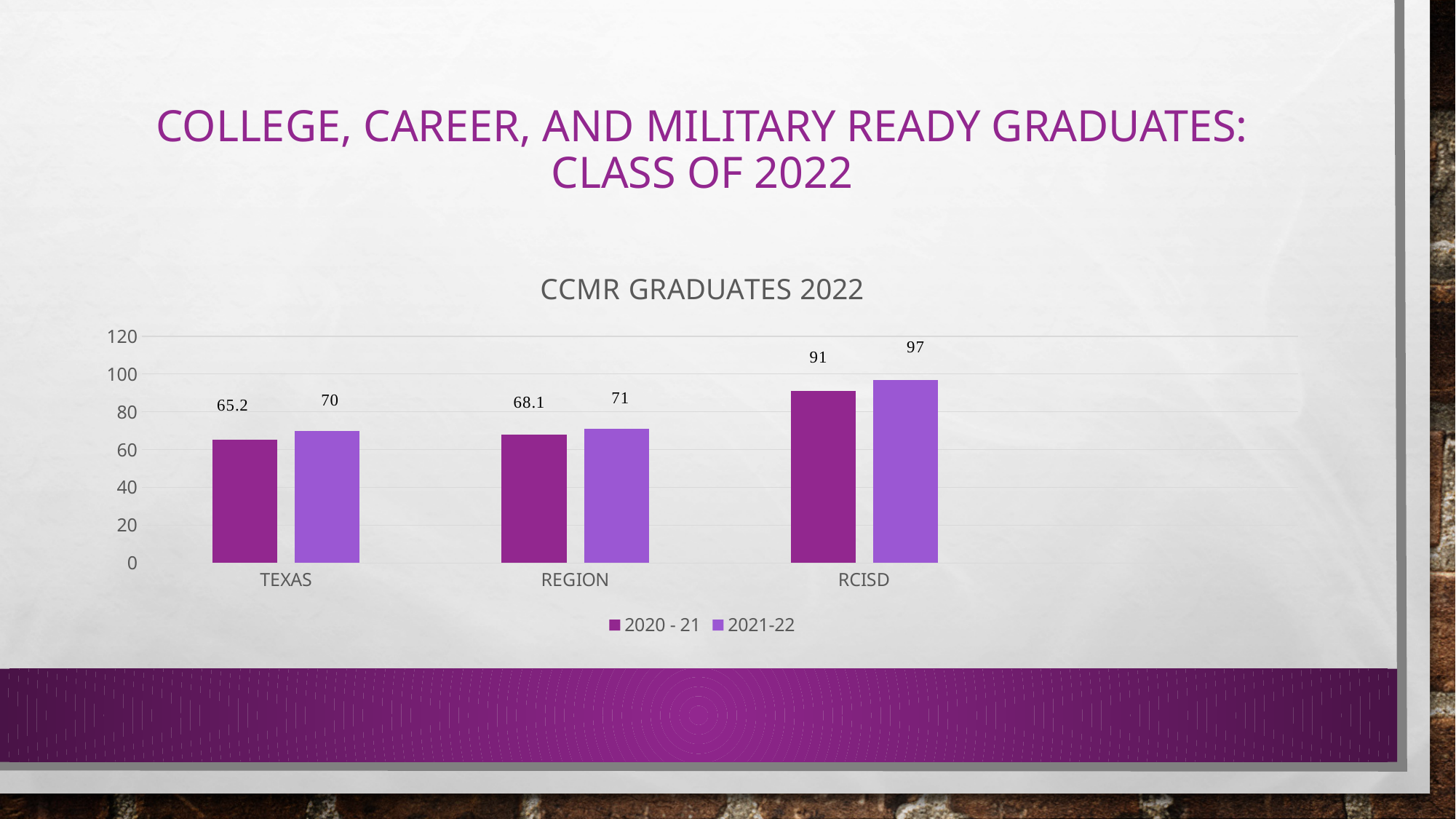
What is the 2021-22 value for Texas? 70 What is the difference between the 2021-22 values for RCISD and Region? 26 What is the difference between the 2021-22 and 2020 - 21 values for RCISD? 6 What is the 2021-22 value for RCISD? 97 How many categories are shown on the x axis? 3 What is the 2020 - 21 value for Texas? 65.2 Which category has the highest 2021-22 value? RCISD What kind of chart is shown on the slide? Bar chart What is the 2020 - 21 value for Region? 68.1 Which is larger, the 2020 - 21 value for Region or the 2020 - 21 value for Texas? Region Which category has the lowest 2020 - 21 value? Texas How many series does the legend list? 2